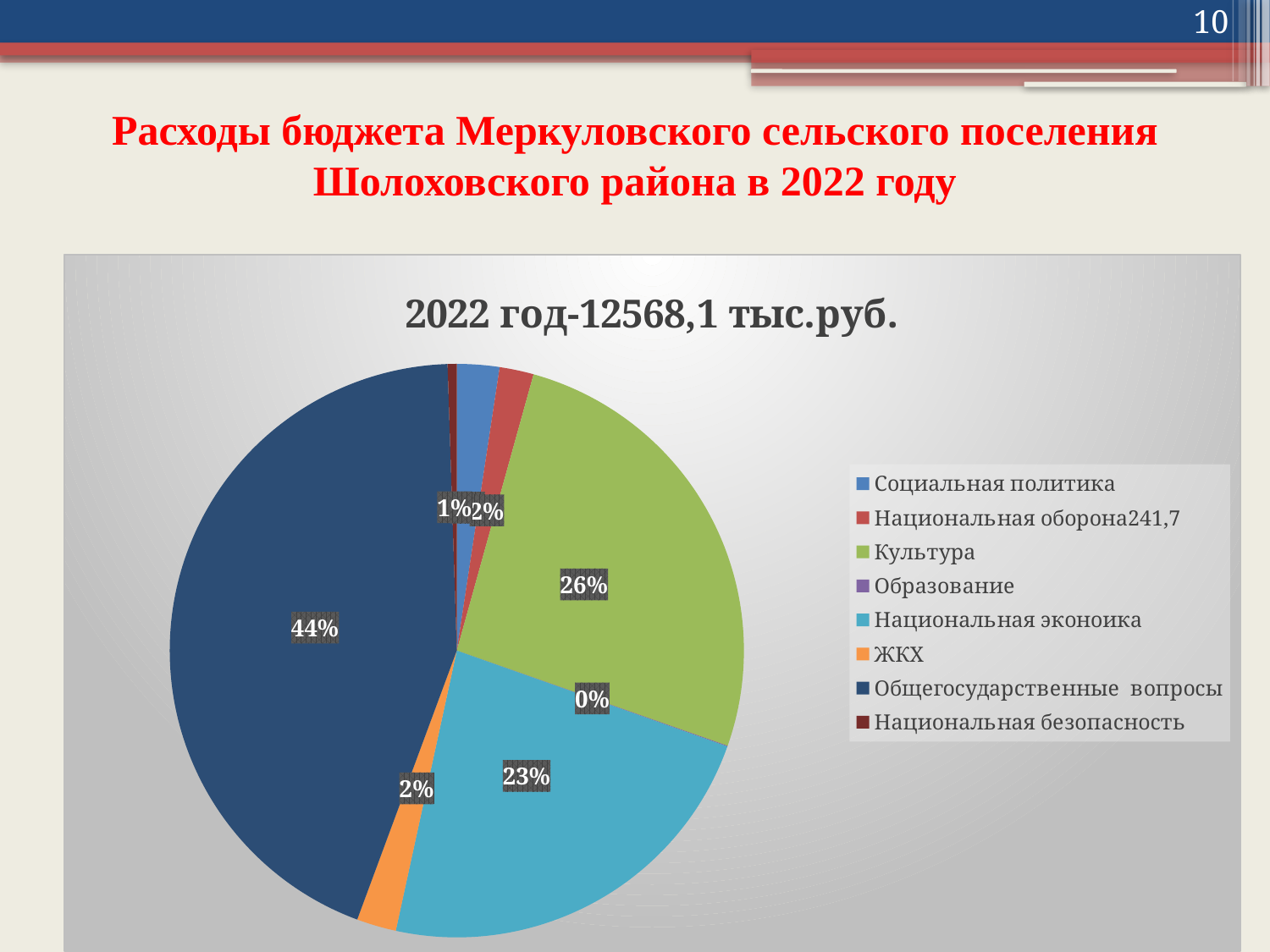
What is the difference in percentage points between the share for Общегосударственные вопросы and the share for Культура? 18 Which category has the largest slice of the pie? Общегосударственные вопросы What share of the pie does Образование take? 0% How many categories does the chart legend list? 8 What share of the pie does ЖКХ take? 2% What share of the pie does Национальная эконоика take? 23% Which category has the smallest slice of the pie? Образование Which is larger, the share for Культура or the share for Национальная эконоика? Культура What is the title of the chart? 2022 год-12568,1 тыс.руб. What kind of chart is shown on the slide? pie chart